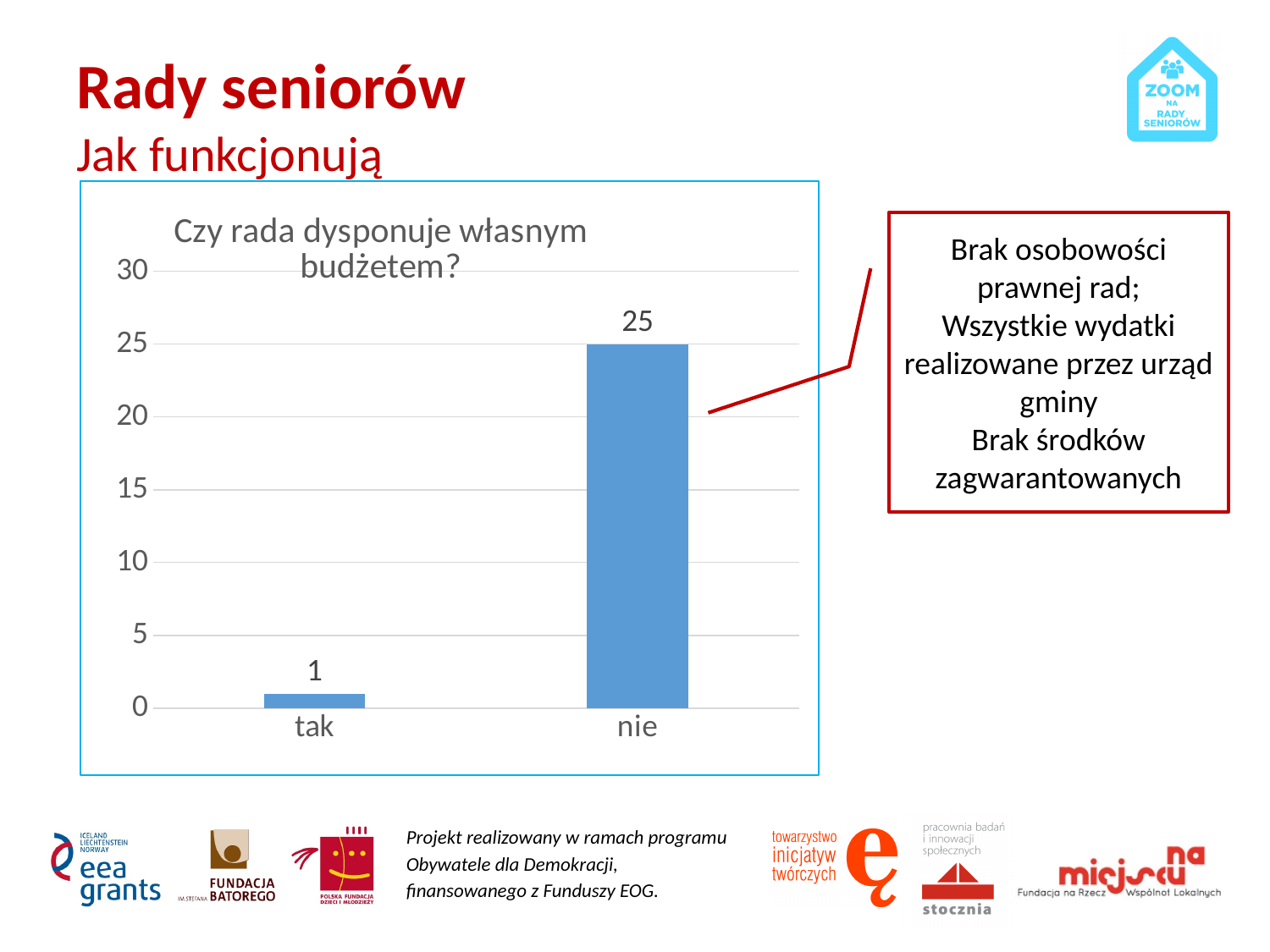
Is the value for "nie" greater or less than 20? greater How many categories are shown on the x axis? 2 Which category has the highest value? nie What kind of chart is shown on the slide? bar chart Is the value for "tak" greater or less than 5? less What is the value for "tak" in the chart? 1 What is the title of the chart? Czy rada dysponuje własnym budżetem? What is the difference between the values for "nie" and "tak"? 24 What is the value for "nie" in the chart? 25 Which category has the lowest value? tak Which is larger, the value for "tak" or the value for "nie"? nie What is the total of the two values shown in the chart? 26